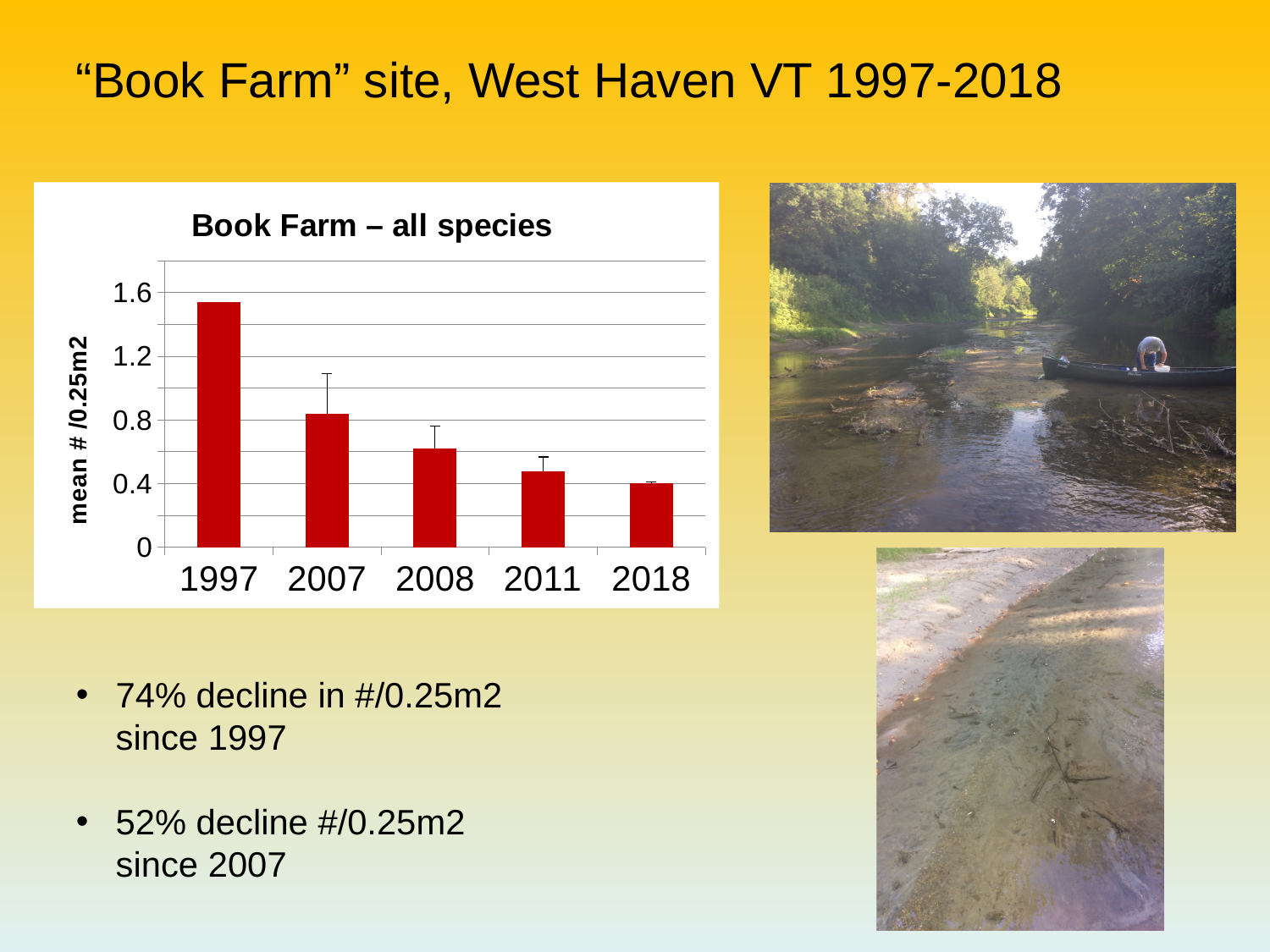
Is the value for 2008 greater or less than 0.8? less Which year has the larger value, 2008 or 2011? 2008 Which year has the larger value, 1997 or 2007? 1997 What is the label on the vertical axis of the chart? mean # /0.25m2 Is the value for 2007 greater or less than 1.2? less What is the title of the chart? Book Farm – all species Which year has the lowest mean # /0.25m2? 2018 What kind of chart is shown on the slide? bar chart Is the value for 1997 greater or less than 1.2? greater Which year has the highest mean # /0.25m2? 1997 How many years (categories) are plotted on the chart? 5 Do the values rise or fall from 1997 to 2018 along the x axis? fall